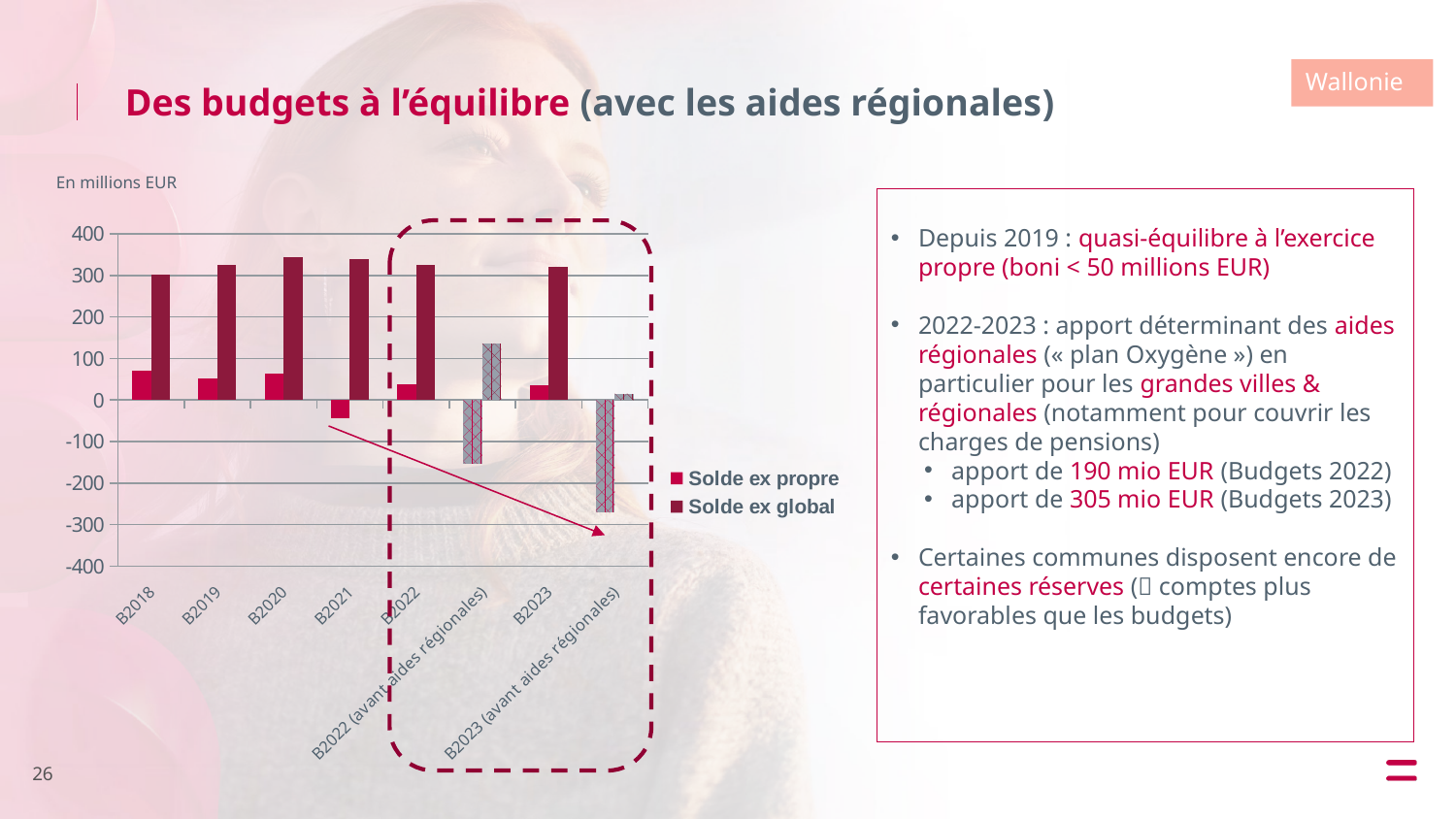
What kind of chart is shown on the slide? bar chart How many categories are shown on the x axis of the chart? 8 Is the Solde ex global value for B2022 (avant aides régionales) greater or less than 100? greater Which is larger: the Solde ex global value for B2018 or for B2022 (avant aides régionales)? B2018 In what unit are the values of the chart expressed, according to the label above it? En millions EUR How many series does the chart's legend list? 2 What are the two series named in the chart's legend? Solde ex propre and Solde ex global Is the Solde ex global value for B2018 greater or less than 200? greater Which category has the lowest value for Solde ex global? B2023 (avant aides régionales) Is the Solde ex propre value for B2021 greater or less than 0? less Which category has the lowest value for Solde ex propre? B2023 (avant aides régionales)